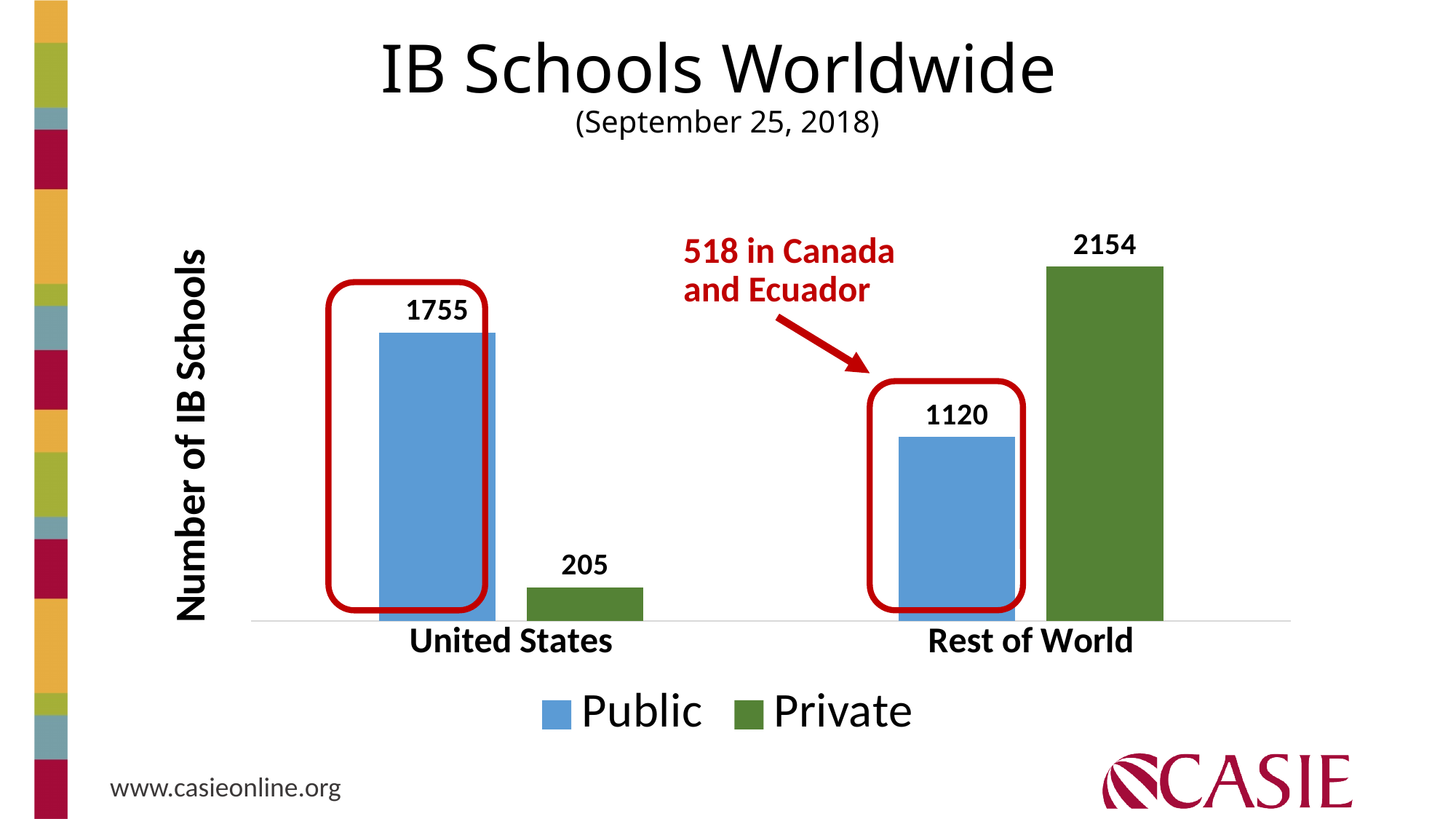
How many private IB schools are there in the United States? 205 How many public IB schools are there in the Rest of World? 1120 How many public IB schools are there in the United States? 1755 Which bar has the lowest value on the chart? Private, United States How many series does the legend list? 2 How many private IB schools are there in the Rest of World? 2154 What is the difference between public and private IB schools in the United States? 1550 What is the difference between private and public IB schools in the Rest of World? 1034 Which is larger: public IB schools in the United States or public IB schools in the Rest of World? United States Which bar has the highest value on the chart? Private, Rest of World According to the annotation, how many of the Rest of World public IB schools are in Canada and Ecuador? 518 What kind of chart is shown on the slide? Bar chart